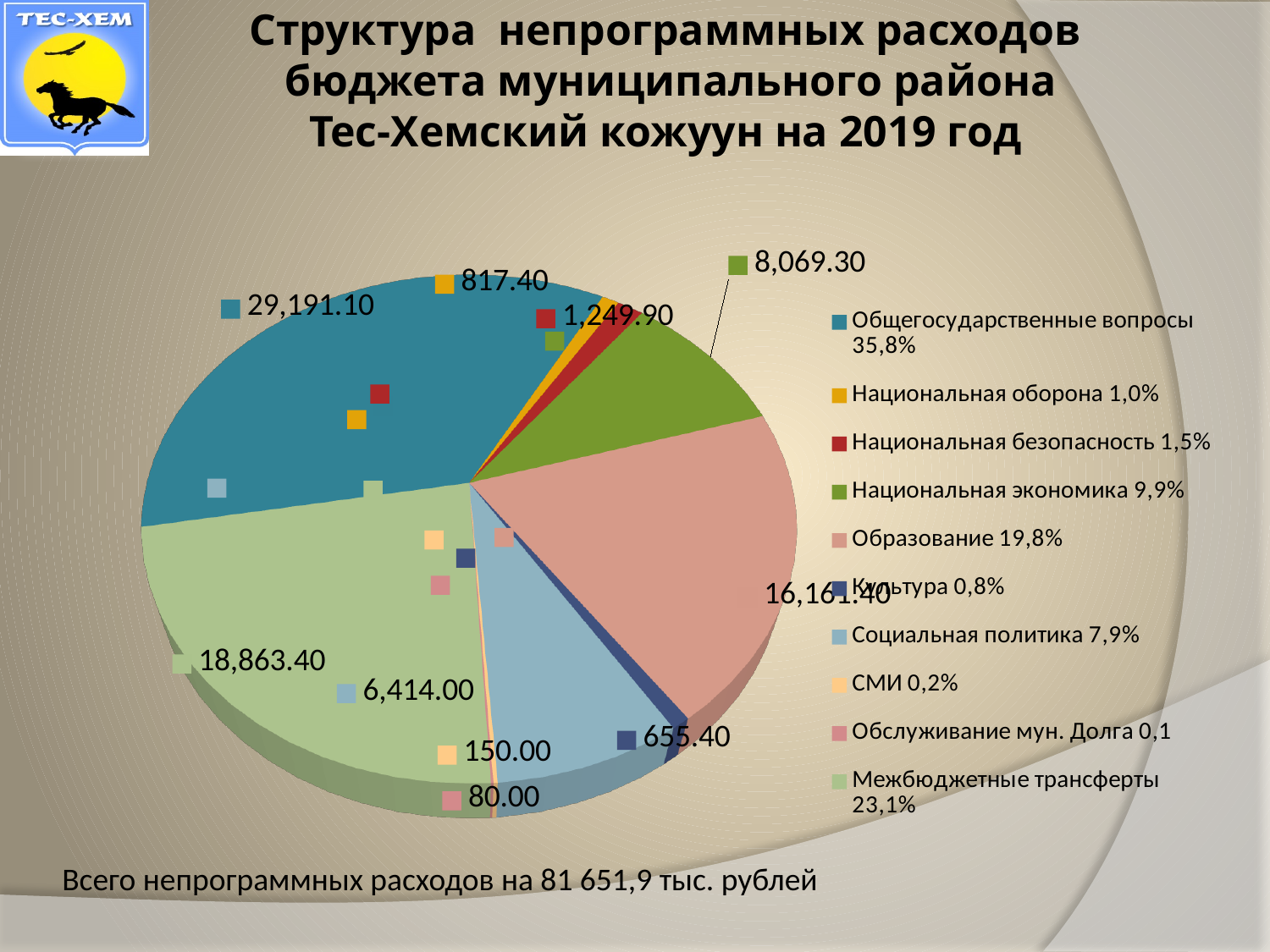
Which is larger, the value for Национальная оборона or for Национальная безопасность? Национальная безопасность Which category has the smallest slice of the pie? Обслуживание мун. Долга What is the difference between the values for Общегосударственные вопросы and Межбюджетные трансферты? 10,327.70 What type of chart is shown on the slide? Pie chart What is the value shown for Общегосударственные вопросы? 29,191.10 How many categories does the pie chart have? 10 According to the text below the chart, what is the total of non-programme expenditures? 81 651,9 тыс. рублей What is the value shown for Межбюджетные трансферты? 18,863.40 Which category has the largest slice of the pie? Общегосударственные вопросы What is the value shown for Национальная экономика? 8,069.30 What share of the pie does Образование represent? 19,8% What is the value shown for Культура? 655.40